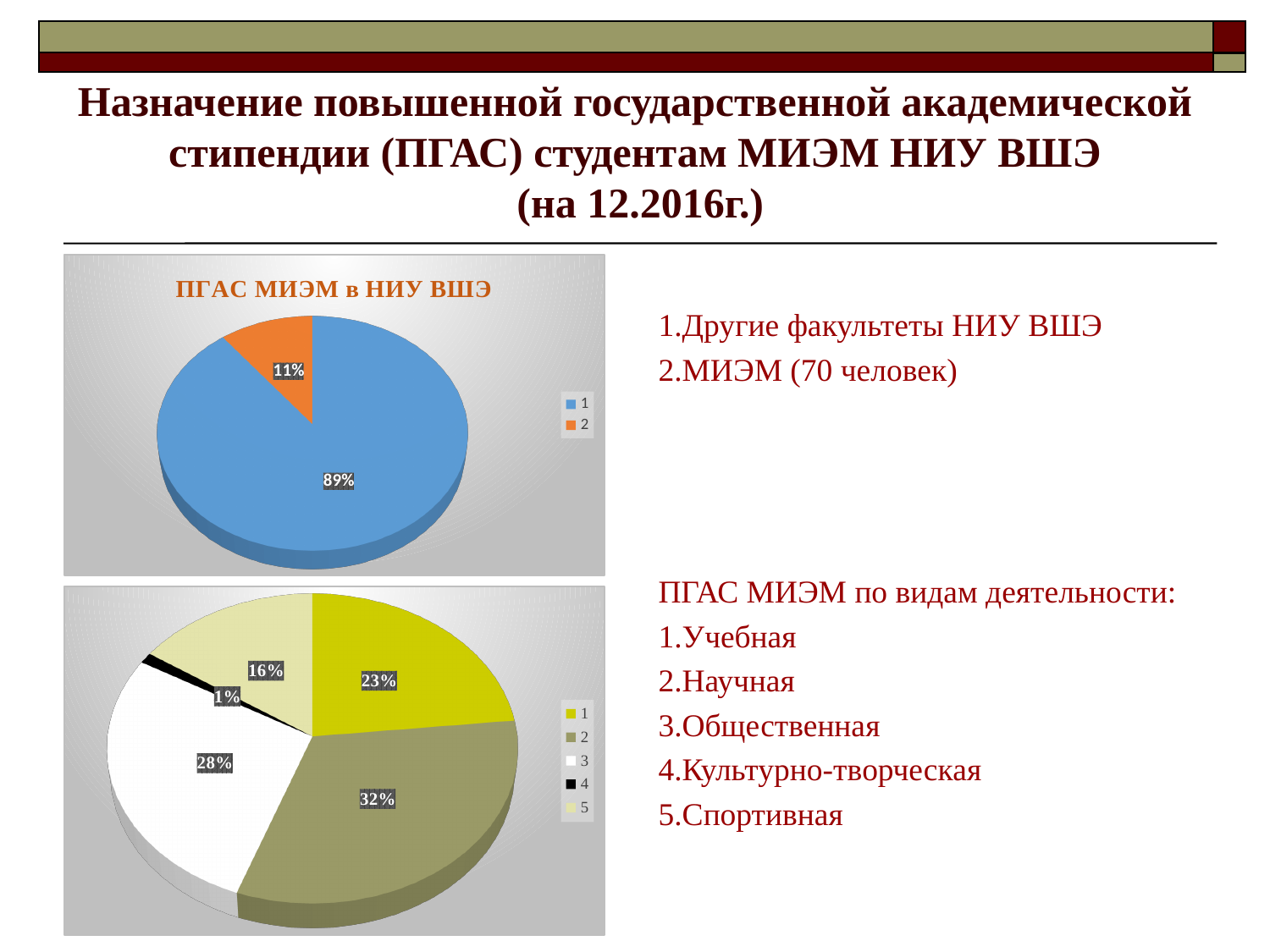
How many series does the legend of the top chart titled "ПГАС МИЭМ в НИУ ВШЭ" list? 2 In the bottom pie chart, which slice is the largest? 2 In the bottom pie chart, what is the difference between slice 2 and slice 1? 9% What kind of chart is the top chart titled "ПГАС МИЭМ в НИУ ВШЭ"? Pie chart In the bottom pie chart, what is the value for slice 5? 16% In the top chart titled "ПГАС МИЭМ в НИУ ВШЭ", what is the difference between slice 1 and slice 2? 78% In the bottom pie chart, which is larger, slice 1 or slice 3? 3 How many slices does the bottom pie chart have? 5 In the bottom pie chart, what is the value for slice 2? 32% In the bottom pie chart, which slice is the smallest? 4 In the top chart titled "ПГАС МИЭМ в НИУ ВШЭ", what share does slice 1 have? 89% In the top chart titled "ПГАС МИЭМ в НИУ ВШЭ", what share does slice 2 have? 11%